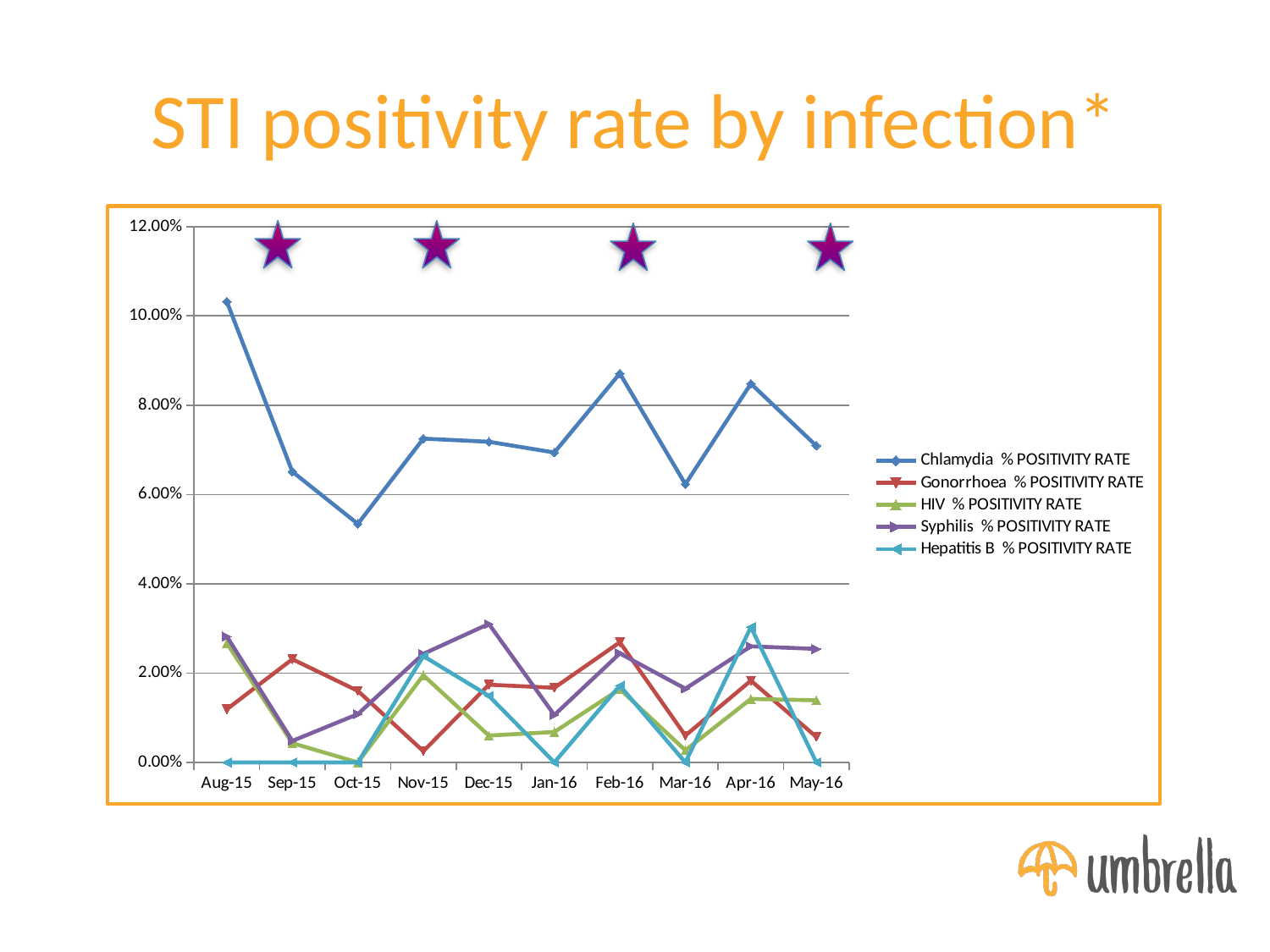
What is the Hepatitis B % POSITIVITY RATE for Aug-15? 0.00% How many series does the legend list? 5 In which month is the Chlamydia % POSITIVITY RATE lowest? Oct-15 How many months are shown on the x axis? 10 In which month is the Chlamydia % POSITIVITY RATE highest? Aug-15 What kind of chart is shown on the slide? line chart Is the Chlamydia % POSITIVITY RATE for Oct-15 greater or less than 6.00%? less Which is larger in Aug-15, the Chlamydia % POSITIVITY RATE or the Gonorrhoea % POSITIVITY RATE? Chlamydia % POSITIVITY RATE Does the Chlamydia % POSITIVITY RATE rise or fall from Aug-15 to Sep-15? fall Is the Chlamydia % POSITIVITY RATE for Aug-15 greater or less than 10.00%? greater Is the Syphilis % POSITIVITY RATE for Dec-15 greater or less than 2.00%? greater What is the title of the slide? STI positivity rate by infection*